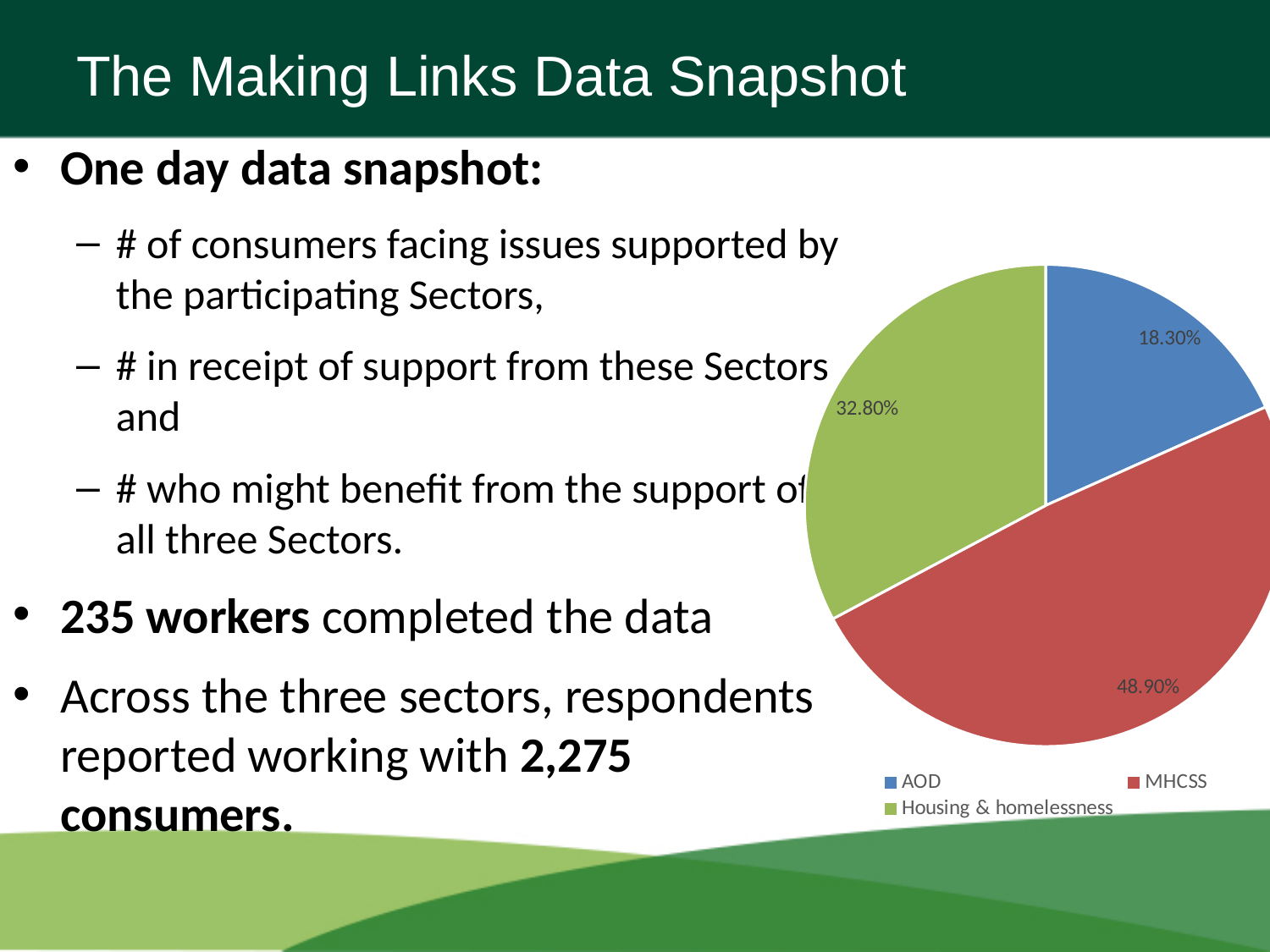
What is the difference in percentage points between the MHCSS share and the AOD share? 30.60% Which sector has the smallest slice of the pie? AOD What colour is the MHCSS slice in the pie chart? red What share of the pie does Housing & homelessness represent? 32.80% Which sector has the largest slice of the pie? MHCSS How many slices does the pie chart have? 3 What kind of chart is shown on the slide? pie chart What is the difference in percentage points between the MHCSS share and the Housing & homelessness share? 16.10% Which is larger, the share for Housing & homelessness or the share for AOD? Housing & homelessness What share of the pie does MHCSS represent? 48.90% How many entries does the legend of the pie chart list? 3 What share of the pie does AOD represent? 18.30%